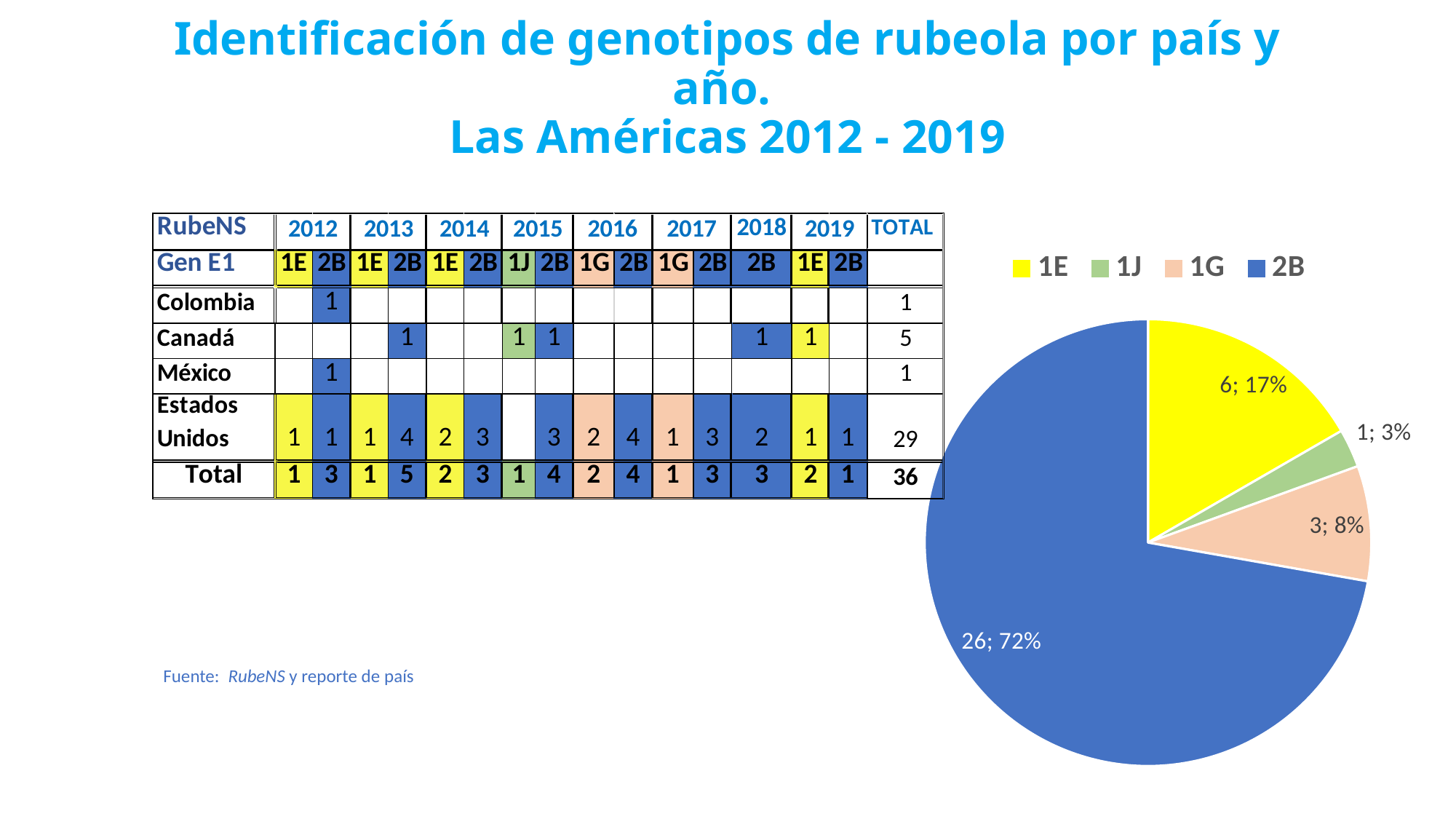
What colour is the 2B slice in the pie chart? blue How many entries does the pie chart's legend list? 4 In the pie chart, what is the difference between the counts for 2B and 1E? 20 In the pie chart, which has the larger count, 1E or 1G? 1E In the pie chart, what percentage is shown for genotype 1J? 3% Which genotype has the smallest slice in the pie chart? 1J Which genotype has the largest slice in the pie chart? 2B In the pie chart, what is the count shown for genotype 1G? 3 What kind of chart is shown on the right of the slide? pie chart In the pie chart, what percentage is shown for genotype 1E? 17% How many slices does the pie chart have? 4 In the pie chart, what is the count shown for genotype 2B? 26